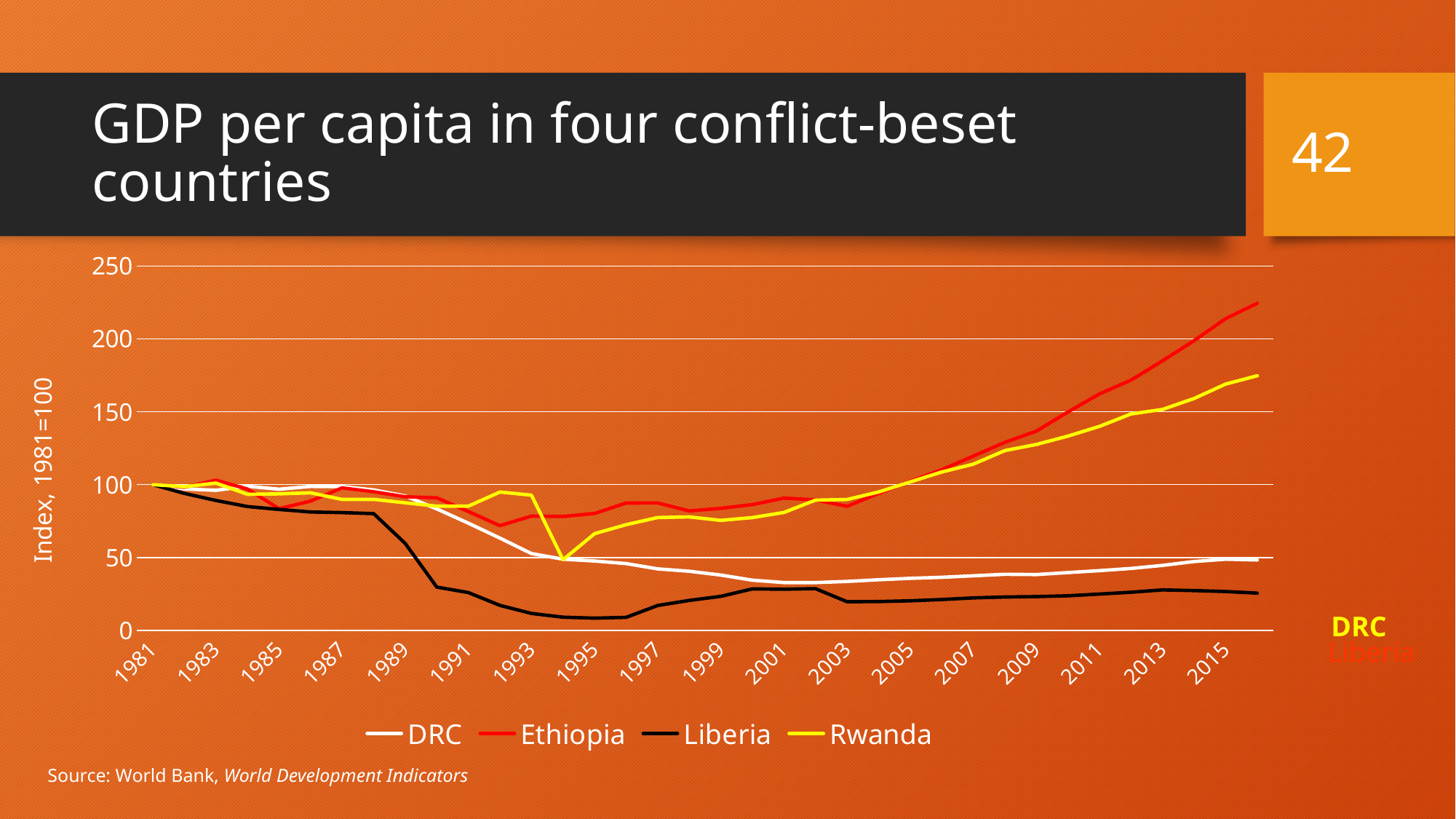
Is the value for Liberia in 1995 greater or less than 50? less What is the index value for all four countries in 1981? 100 How many series does the legend list? 4 What is the title of the chart? GDP per capita in four conflict-beset countries Which country has the highest index value in 2015? Ethiopia Which country has the lowest index value in 2015? Liberia Is the value for Rwanda in 2015 greater or less than 150? greater In 2015, which is higher, DRC or Liberia? DRC What kind of chart is shown on the slide? line chart Is the value for Ethiopia in 2015 greater or less than 200? greater What is the label on the vertical axis? Index, 1981=100 Does the Ethiopia line rise or fall between 2003 and 2015? rise